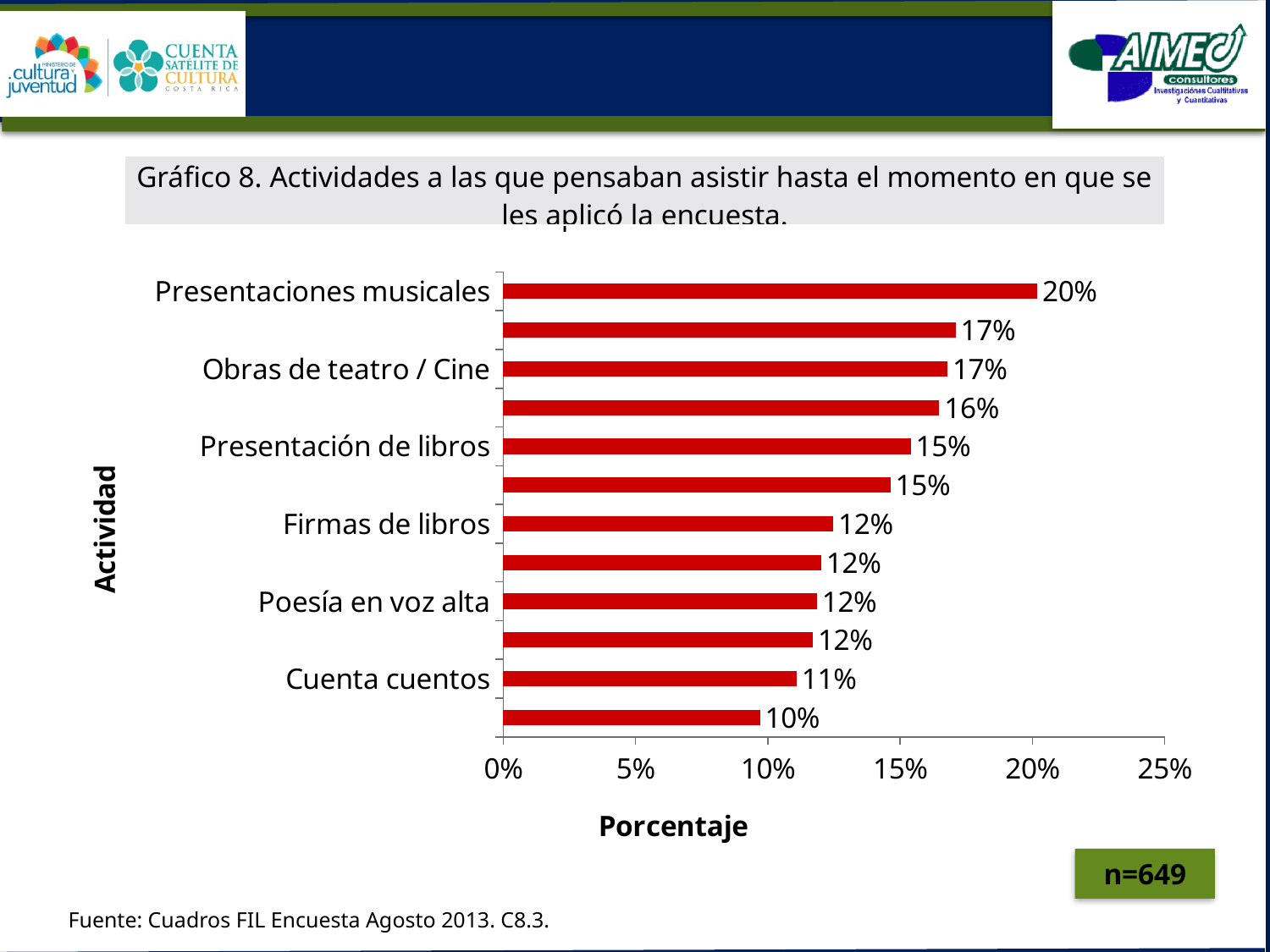
What is the lowest percentage value shown on the chart? 10% What is the difference between the values for Presentaciones musicales and Cuenta cuentos? 9% What is the title of the horizontal axis? Porcentaje Which is larger, the value for Obras de teatro / Cine or for Presentación de libros? Obras de teatro / Cine What percentage is shown for Presentación de libros? 15% What type of chart is shown on the slide? Bar chart Which activity has the highest percentage? Presentaciones musicales What percentage is shown for Cuenta cuentos? 11% How many bars are plotted on the chart? 12 What is the value for Firmas de libros? 12% What is the value for Obras de teatro / Cine? 17% What percentage is shown for Presentaciones musicales? 20%